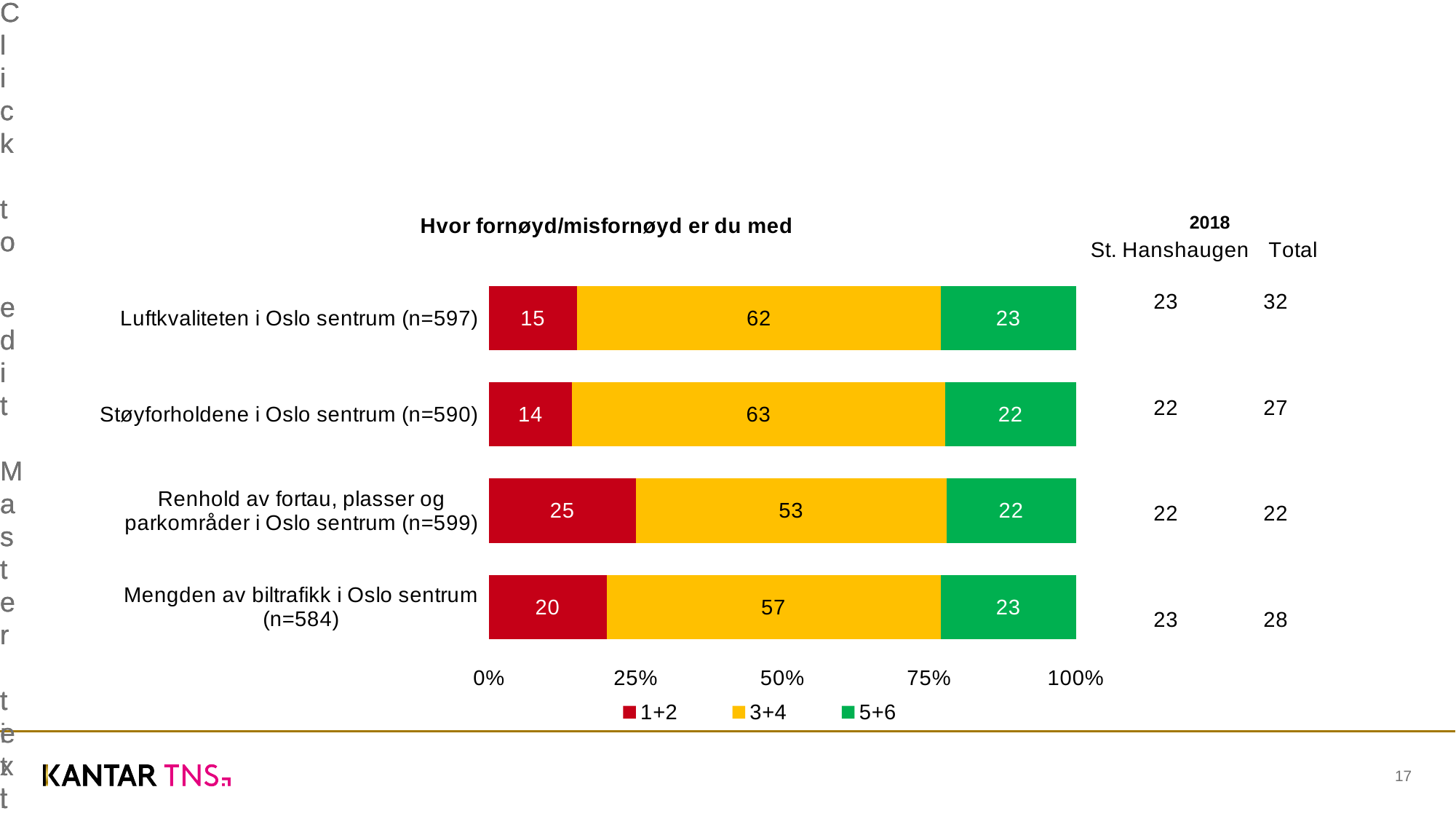
What is the value of the 1+2 series for "Mengden av biltrafikk i Oslo sentrum (n=584)"? 20 What is the value of the 5+6 series for "Renhold av fortau, plasser og parkområder i Oslo sentrum (n=599)"? 22 What type of chart is shown on the slide? Stacked bar chart Which category has the lowest value for the 3+4 series? Renhold av fortau, plasser og parkområder i Oslo sentrum (n=599) How many series does the legend list? 3 What is the difference between the 3+4 values for "Luftkvaliteten i Oslo sentrum (n=597)" and "Mengden av biltrafikk i Oslo sentrum (n=584)"? 5 What is the value of the 1+2 series for "Luftkvaliteten i Oslo sentrum (n=597)"? 15 Which category has the highest value for the 1+2 series? Renhold av fortau, plasser og parkområder i Oslo sentrum (n=599) Which is larger: the 1+2 value for "Renhold av fortau, plasser og parkområder i Oslo sentrum (n=599)" or the 1+2 value for "Støyforholdene i Oslo sentrum (n=590)"? Renhold av fortau, plasser og parkområder i Oslo sentrum (n=599) What is the title of the chart? Hvor fornøyd/misfornøyd er du med What is the value of the 3+4 series for "Støyforholdene i Oslo sentrum (n=590)"? 63 How many categories are plotted in the chart? 4